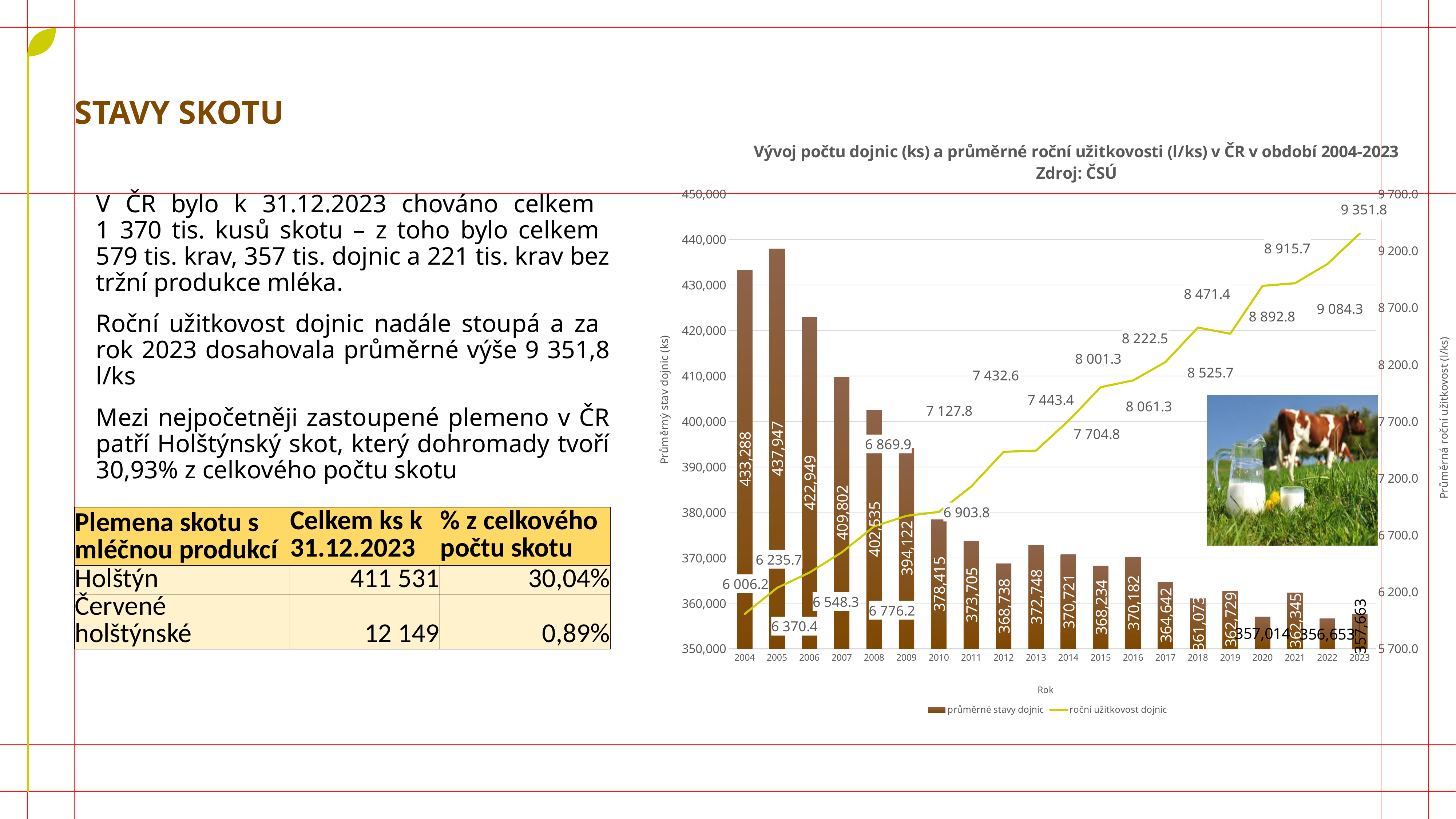
Does the annual milk yield line rise or fall from 2004 to 2023? Rises What kind of chart is shown on the slide? Combined bar and line chart What is the difference between the average number of dairy cows in 2005 and in 2023? 80,284 What annual milk yield is labelled for 2004? 6 006.2 Which year has the lowest average number of dairy cows? 2022 Which year has the highest average number of dairy cows? 2005 Which year has more dairy cows, 2013 or 2015? 2013 What is the average number of dairy cows shown for 2023? 357,663 How many years are shown on the x axis of the chart? 20 How many series does the chart legend list? 2 What annual milk yield (roční užitkovost dojnic) is labelled for 2023? 9 351.8 What is the average number of dairy cows (průměrné stavy dojnic) shown for 2004? 433,288